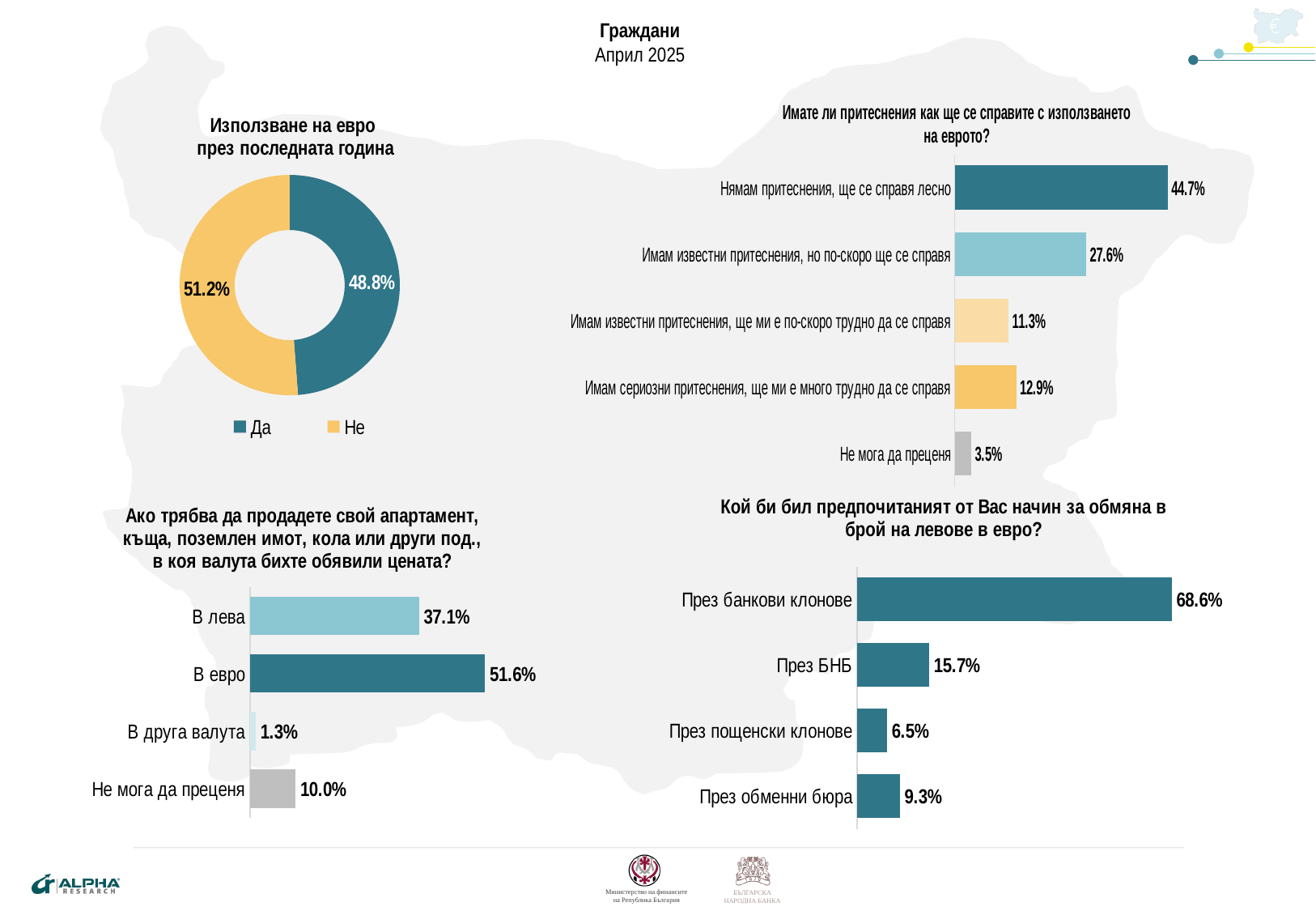
In the bottom-left bar chart about the currency in which respondents would announce a price, which category has the highest value? В евро In the top-right bar chart 'Имате ли притеснения как ще се справите с използването на еврото?', which category has the lowest value? Не мога да преценя In the top-right bar chart 'Имате ли притеснения как ще се справите с използването на еврото?', what is the difference between 'Нямам притеснения, ще се справя лесно' and 'Имам известни притеснения, но по-скоро ще се справя'? 17.1% In the bottom-left bar chart about the currency in which respondents would announce a price, what is the difference between 'В евро' and 'В лева'? 14.5% In the top-left donut chart 'Използване на евро през последната година', which answer has the larger share, 'Да' or 'Не'? Не In the top-right bar chart 'Имате ли притеснения как ще се справите с използването на еврото?', how many categories are shown? 5 In the bottom-right bar chart 'Кой би бил предпочитаният от Вас начин за обмяна в брой на левове в евро?', what is the value for 'През БНБ'? 15.7% What type of chart is the top-left chart 'Използване на евро през последната година'? Donut (pie) chart In the bottom-left bar chart about the currency in which respondents would announce a price, what is the value for 'В евро'? 51.6% In the top-right bar chart 'Имате ли притеснения как ще се справите с използването на еврото?', what is the value for 'Нямам притеснения, ще се справя лесно'? 44.7% In the bottom-right bar chart 'Кой би бил предпочитаният от Вас начин за обмяна в брой на левове в евро?', which is larger, 'През пощенски клонове' or 'През обменни бюра'? През обменни бюра In the top-left donut chart 'Използване на евро през последната година', what share answered 'Да'? 48.8%